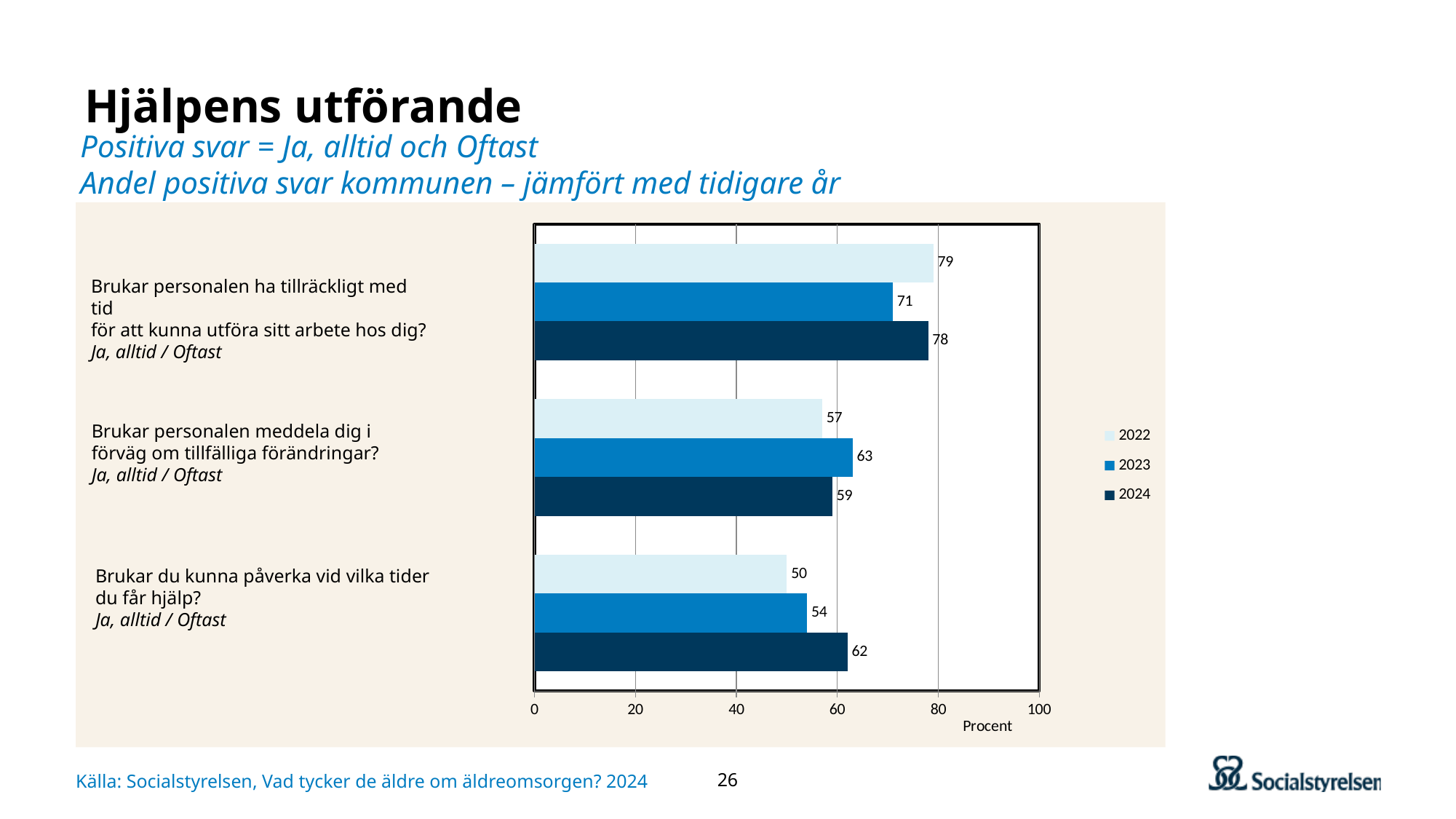
What is the 2023 value for "Brukar du kunna påverka vid vilka tider du får hjälp?" 54 For "Brukar personalen meddela dig i förväg om tillfälliga förändringar?", which year has the larger value, 2023 or 2024? 2023 What is the 2024 value for "Brukar personalen ha tillräckligt med tid för att kunna utföra sitt arbete hos dig?" 78 What is the 2022 value for "Brukar personalen meddela dig i förväg om tillfälliga förändringar?" 57 How many series does the legend list? 3 What is the label of the x axis? Procent What kind of chart is shown on the slide? Bar chart What is the difference between the 2024 and 2022 values for "Brukar du kunna påverka vid vilka tider du får hjälp?" 12 Which question has the lowest 2024 value? Brukar personalen meddela dig i förväg om tillfälliga förändringar? Which question has the highest 2022 value? Brukar personalen ha tillräckligt med tid för att kunna utföra sitt arbete hos dig? How many questions (categories) are shown on the chart? 3 Which years are listed in the legend? 2022, 2023, 2024